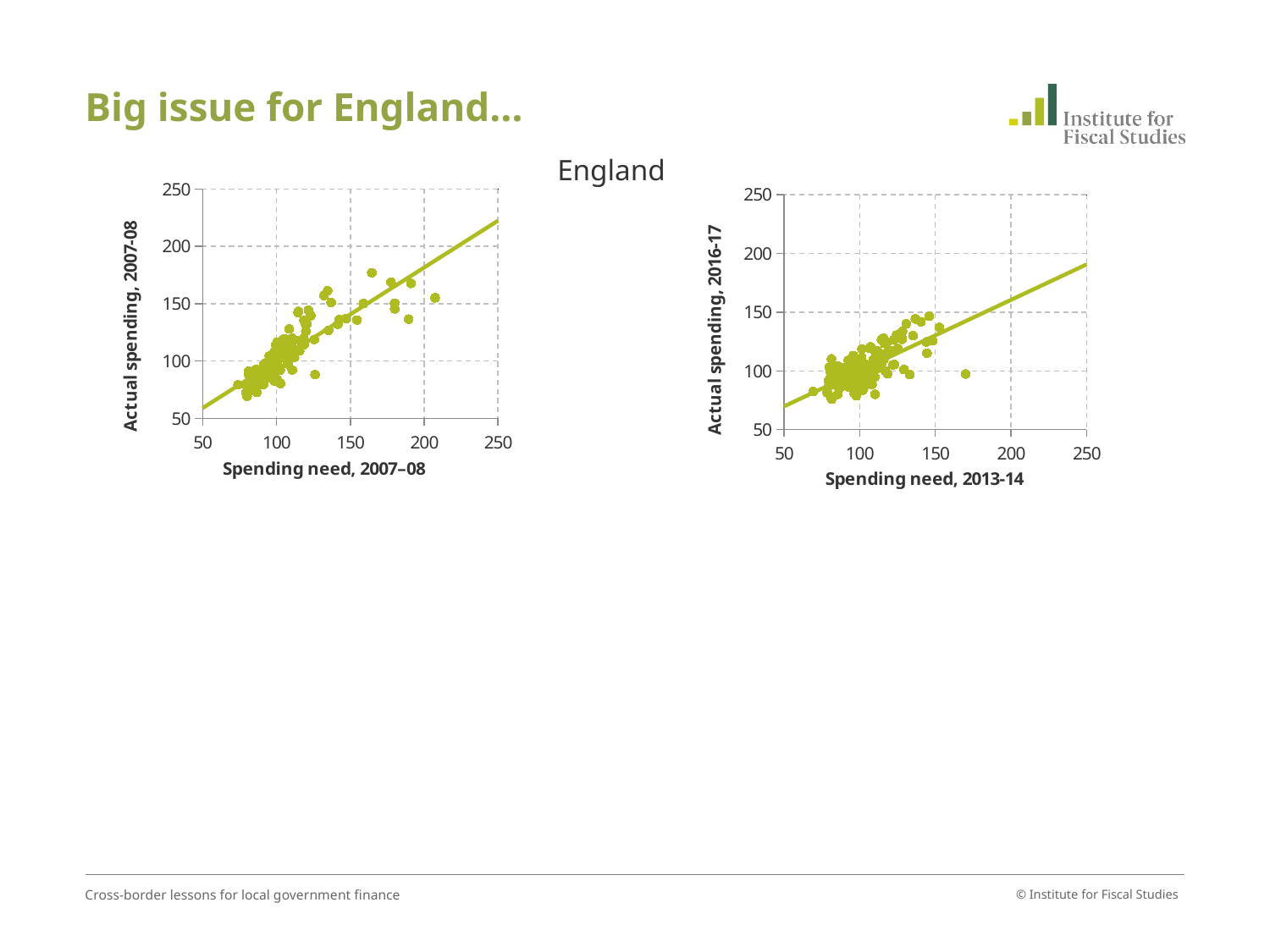
What kind of chart is the left chart, with x axis 'Spending need, 2007–08'? scatter chart What is the x-axis title of the right chart? Spending need, 2013-14 In the right chart, is the value of the trend line at a spending need of 250 greater or less than 200? less In the right chart, does actual spending tend to rise or fall as spending need increases along the x axis? rise In the left chart, is the highest plotted point's actual spending greater or less than 200? less In the left chart, does actual spending tend to rise or fall as spending need increases along the x axis? rise In the right chart, is the highest plotted point's actual spending greater or less than 200? less What is the y-axis title of the left chart? Actual spending, 2007-08 What is the maximum value shown on the y axis of the right chart? 250 Which chart's trend line reaches a higher value at a spending need of 250, the left chart (2007–08) or the right chart (2013-14)? the left chart (2007–08) What kind of chart is the right chart, with x axis 'Spending need, 2013-14'? scatter chart